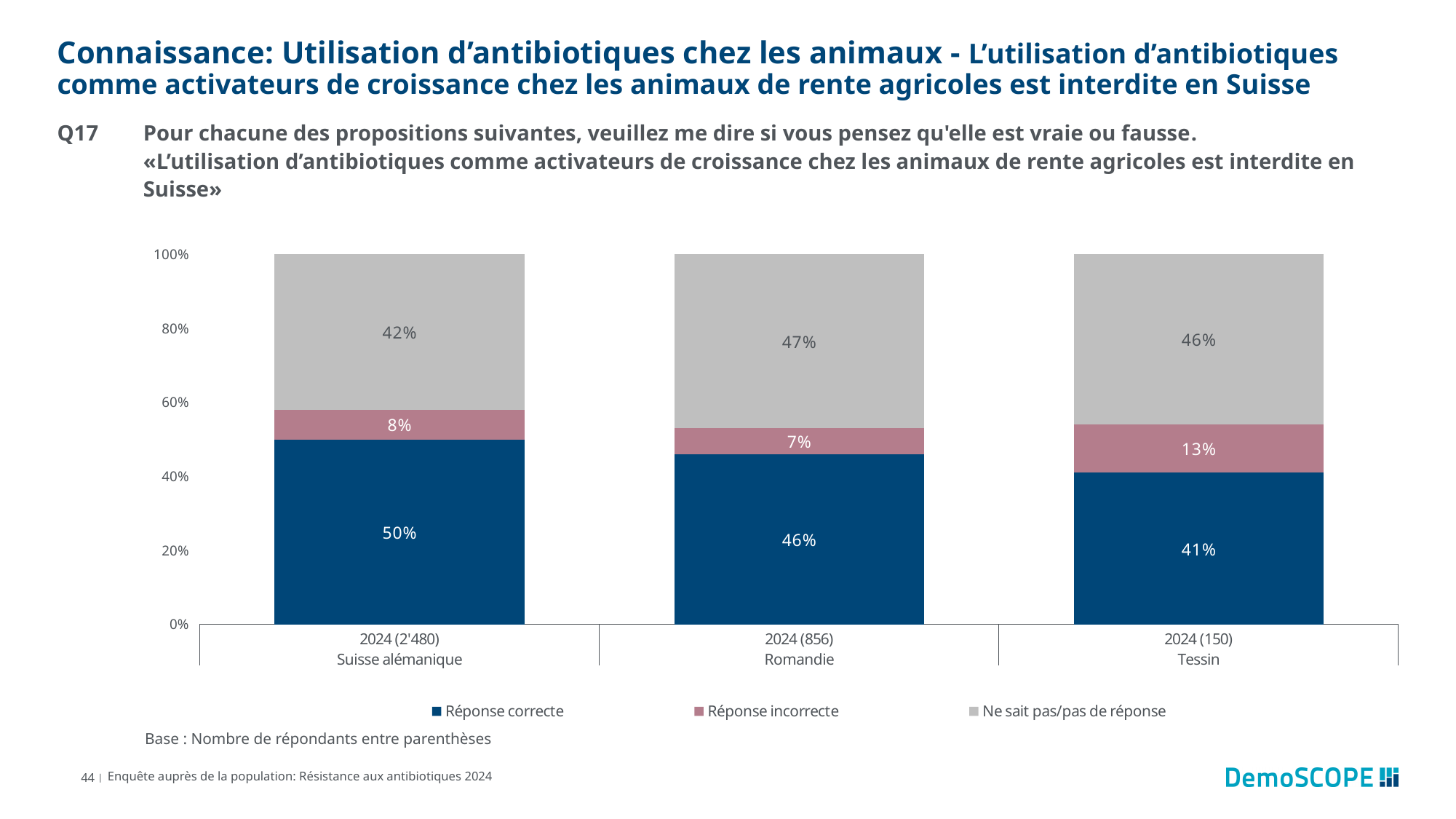
Which is larger: 'Ne sait pas/pas de réponse' in Romandie or in Tessin? Romandie What is the value for 'Réponse incorrecte' in Tessin? 13% What is the number of respondents shown in parentheses for Romandie? 856 How many series does the legend list? 3 What is the value for 'Ne sait pas/pas de réponse' in Romandie? 47% Do the 'Réponse correcte' values rise or fall from Suisse alémanique to Tessin? Fall What is the difference between the 'Réponse correcte' values for Suisse alémanique and Tessin? 9 percentage points Which region has the highest value for 'Réponse correcte'? Suisse alémanique Which region has the lowest value for 'Réponse incorrecte'? Romandie What is the value for 'Réponse correcte' in Suisse alémanique? 50% How many regions (categories) are shown on the x axis? 3 What kind of chart is shown on the slide? Stacked bar chart